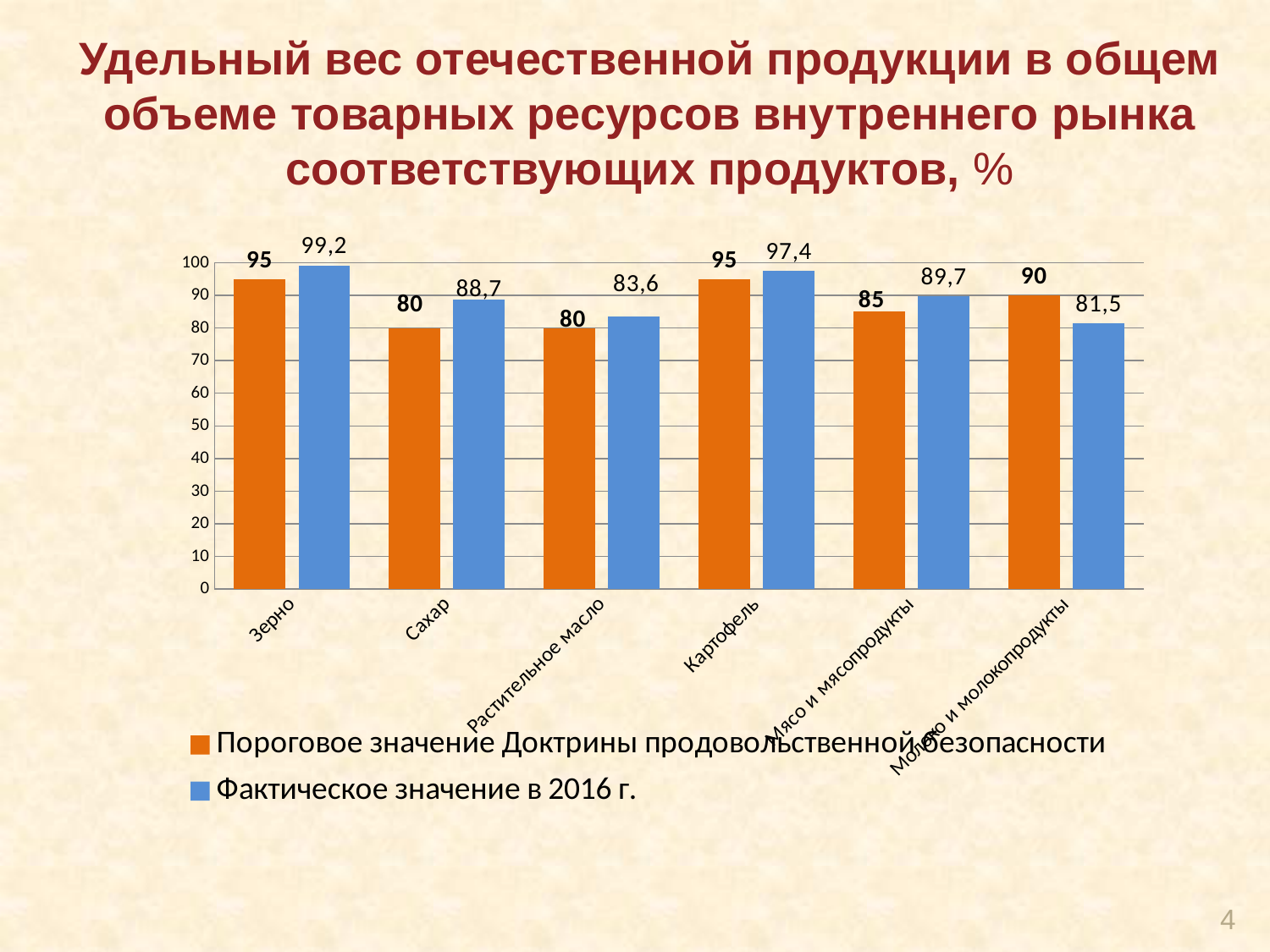
Which category has the highest actual 2016 value? Зерно Which colour represents the series 'Фактическое значение в 2016 г.'? Blue What is the difference between the actual 2016 value and the threshold value for Сахар? 8,7 For Молоко и молокопродукты, which is larger: the threshold value or the actual 2016 value? Пороговое значение (90) Which category has the lowest actual 2016 value? Молоко и молокопродукты What kind of chart is shown on the slide? Bar chart What is the threshold value (Пороговое значение) for Мясо и мясопродукты? 85 What is the actual 2016 value for Молоко и молокопродукты? 81,5 What is the actual 2016 value (Фактическое значение в 2016 г.) for Зерно? 99,2 How many product categories are shown on the x axis? 6 How many series does the legend list? 2 What is the actual 2016 value for Картофель? 97,4